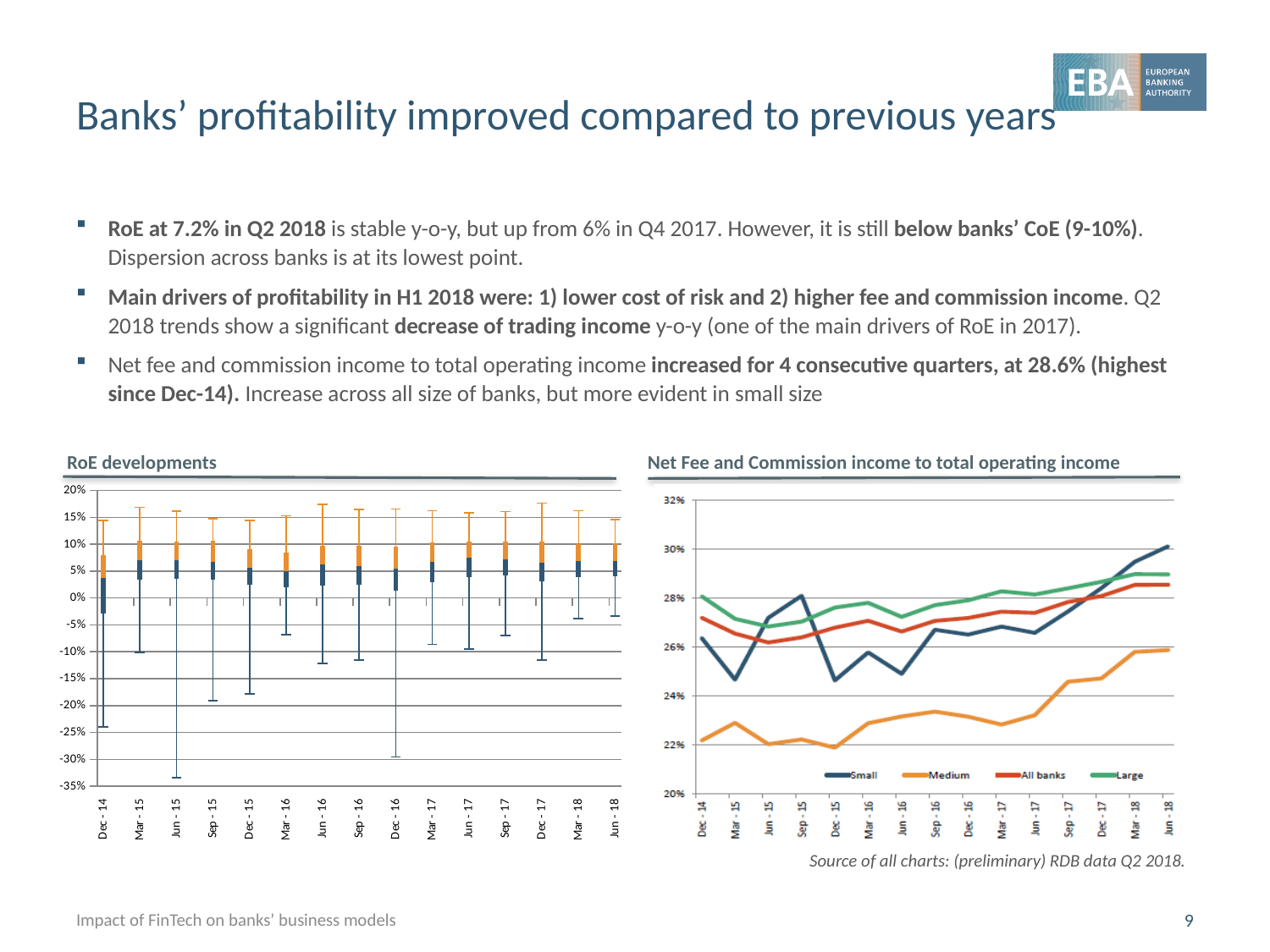
In the 'Net Fee and Commission income to total operating income' chart, which series has the highest value at Jun-18? Small In the 'Net Fee and Commission income to total operating income' chart, which series has the lowest value at Jun-18? Medium In the 'Net Fee and Commission income to total operating income' chart, which is larger at Sep-15: Small or Large? Small In the 'Net Fee and Commission income to total operating income' chart, does the Medium series overall rise or fall from Dec-14 to Jun-18? rise How many series does the legend of the 'Net Fee and Commission income to total operating income' chart list? 4 In the 'RoE developments' chart, is the bottom whisker at Jun-15 greater or less than -30%? less In the 'RoE developments' chart, which time point has the lowest bottom whisker? Jun-15 In the 'Net Fee and Commission income to total operating income' chart, is the value for Small at Jun-18 greater or less than 30%? greater What kind of chart is the 'Net Fee and Commission income to total operating income' chart? line chart In the 'Net Fee and Commission income to total operating income' chart, is the value for Small at Mar-15 greater or less than 26%? less How many time points are shown on the x axis of the 'RoE developments' chart? 15